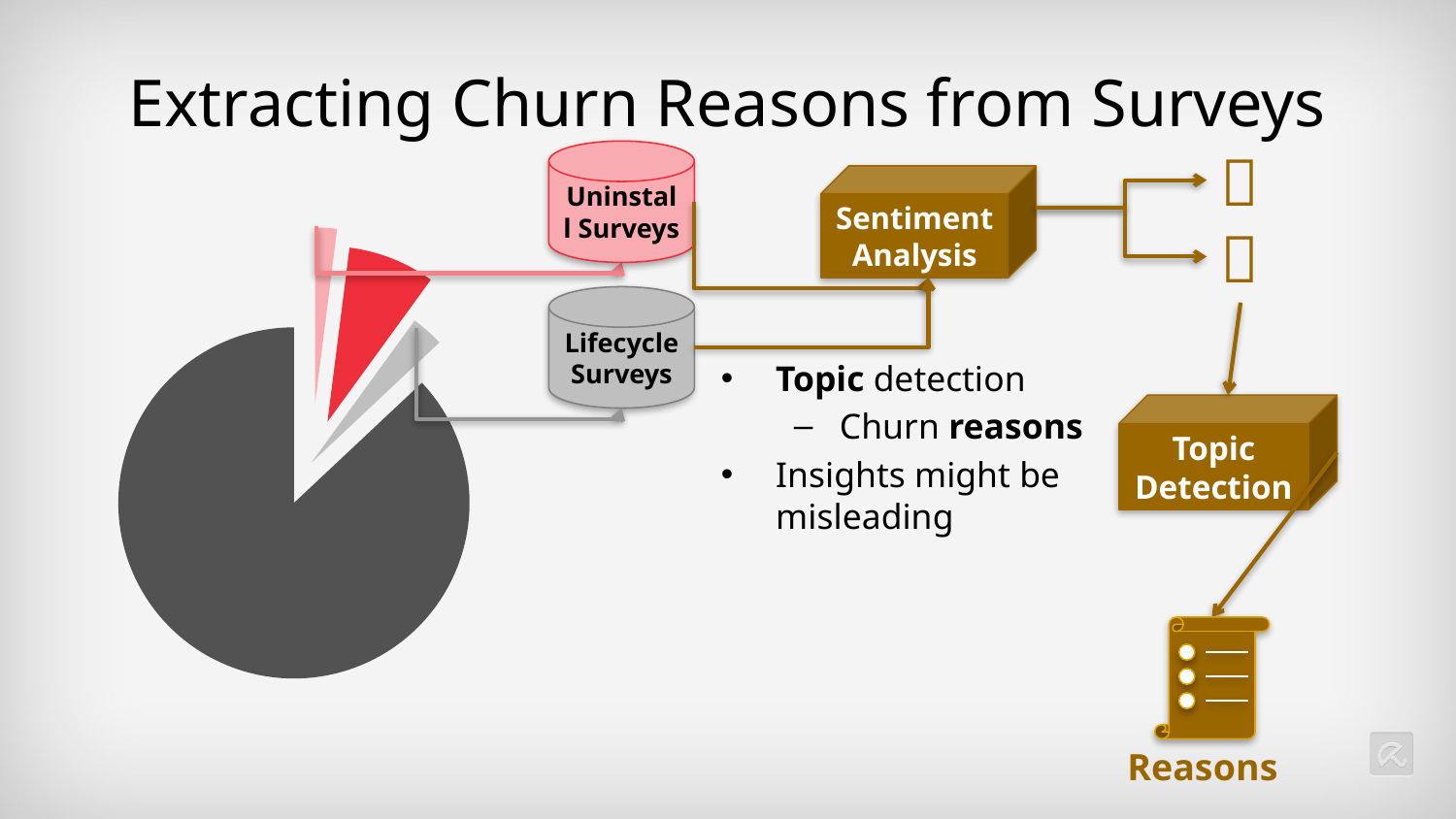
What kind of chart is shown on the left of the slide? pie chart Does the pie chart show any data labels with values? No Does the pie chart have a legend? No Which slice of the pie chart is the largest? the dark gray slice Does the dark gray slice of the pie chart cover more or less than half of the pie? more Which is larger in the pie chart, the dark gray slice or the red slice? the dark gray slice